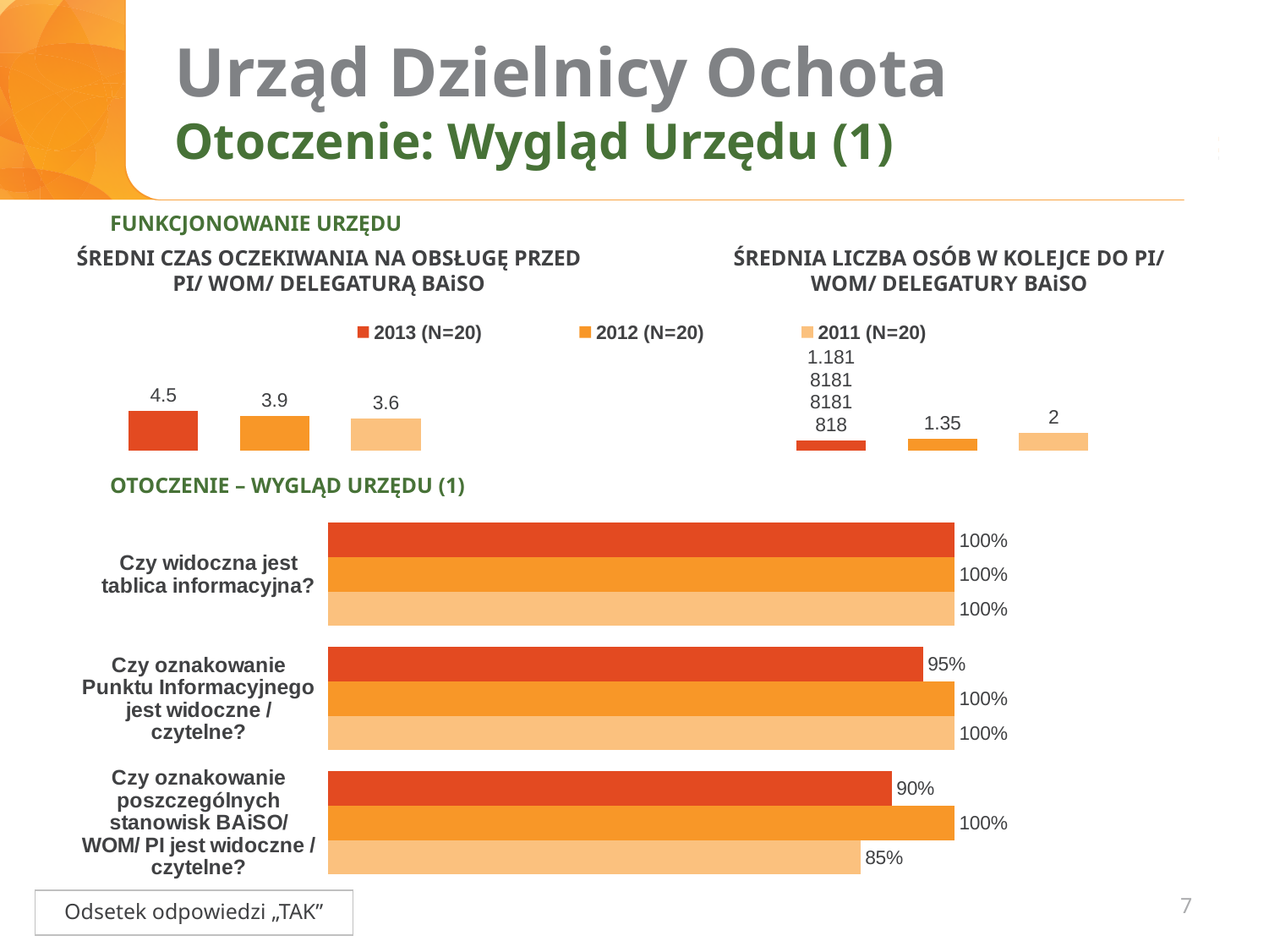
In the chart 'OTOCZENIE – WYGLĄD URZĘDU (1)', what is the 2011 value for 'Czy oznakowanie poszczególnych stanowisk BAiSO/ WOM/ PI jest widoczne / czytelne?'? 85% In the chart 'ŚREDNIA LICZBA OSÓB W KOLEJCE DO PI/ WOM/ DELEGATURY BAiSO', which year has the highest value? 2011 (N=20) In the chart 'ŚREDNI CZAS OCZEKIWANIA NA OBSŁUGĘ PRZED PI/ WOM/ DELEGATURĄ BAiSO', which year has the highest value? 2013 (N=20) In the chart 'ŚREDNIA LICZBA OSÓB W KOLEJCE DO PI/ WOM/ DELEGATURY BAiSO', what is the value for 2012 (N=20)? 1.35 How many question categories are shown in the chart 'OTOCZENIE – WYGLĄD URZĘDU (1)'? 3 How many series does the legend on the slide list? 3 In the chart 'ŚREDNI CZAS OCZEKIWANIA NA OBSŁUGĘ PRZED PI/ WOM/ DELEGATURĄ BAiSO', what is the difference between the 2013 and 2012 values? 0.6 In the chart 'OTOCZENIE – WYGLĄD URZĘDU (1)', which is larger for 'Czy oznakowanie poszczególnych stanowisk BAiSO/ WOM/ PI jest widoczne / czytelne?': the 2013 value or the 2011 value? 2013 In the chart 'ŚREDNI CZAS OCZEKIWANIA NA OBSŁUGĘ PRZED PI/ WOM/ DELEGATURĄ BAiSO', what is the value for 2013 (N=20)? 4.5 In the chart 'ŚREDNI CZAS OCZEKIWANIA NA OBSŁUGĘ PRZED PI/ WOM/ DELEGATURĄ BAiSO', what is the value for 2011 (N=20)? 3.6 In the chart 'OTOCZENIE – WYGLĄD URZĘDU (1)', what is the difference between the 2012 and 2011 values for 'Czy oznakowanie poszczególnych stanowisk BAiSO/ WOM/ PI jest widoczne / czytelne?'? 15% In the chart 'OTOCZENIE – WYGLĄD URZĘDU (1)', what is the 2013 value for 'Czy oznakowanie Punktu Informacyjnego jest widoczne / czytelne?'? 95%